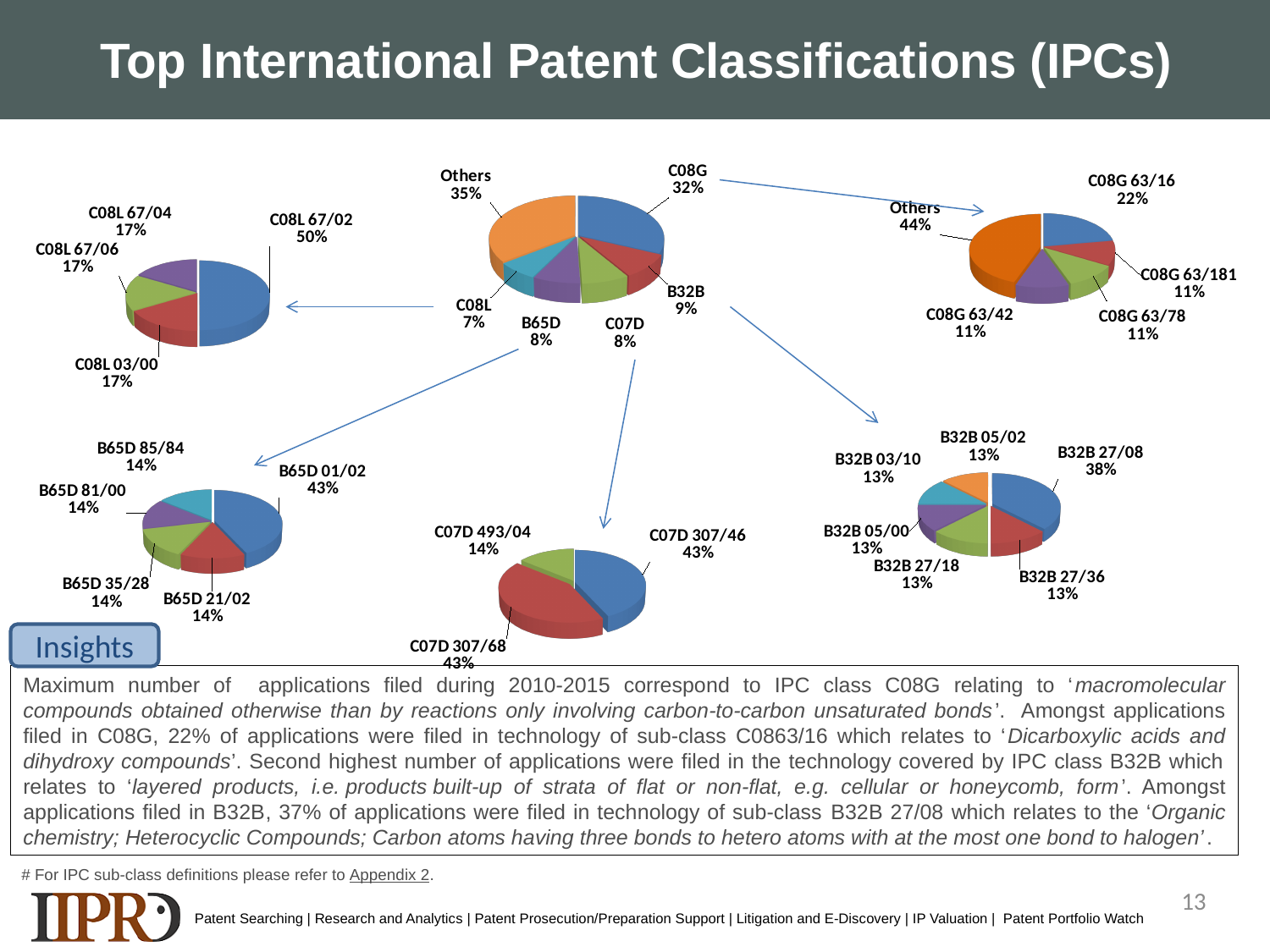
In the bottom-right pie chart, how many slices are shown? 6 In the bottom-centre pie chart, what share is labelled for C07D 493/04? 14% In the bottom-left pie chart, which sub-class has the largest share? B65D 01/02 In the bottom-right pie chart, what share is labelled for B32B 27/08? 38% In the central pie chart, which slice has the smallest share? C08L In the central pie chart, what is the difference between the shares of C08G and B32B? 23% In the top-left pie chart, what share is labelled for C08L 67/02? 50% What type of chart is used throughout this slide? Pie chart In the top-right pie chart, what share is labelled for C08G 63/16? 22% In the central pie chart, what share is labelled for C08G? 32% In the central pie chart, which named IPC class (excluding Others) has the largest share? C08G In the top-right pie chart, how many slices are shown? 5